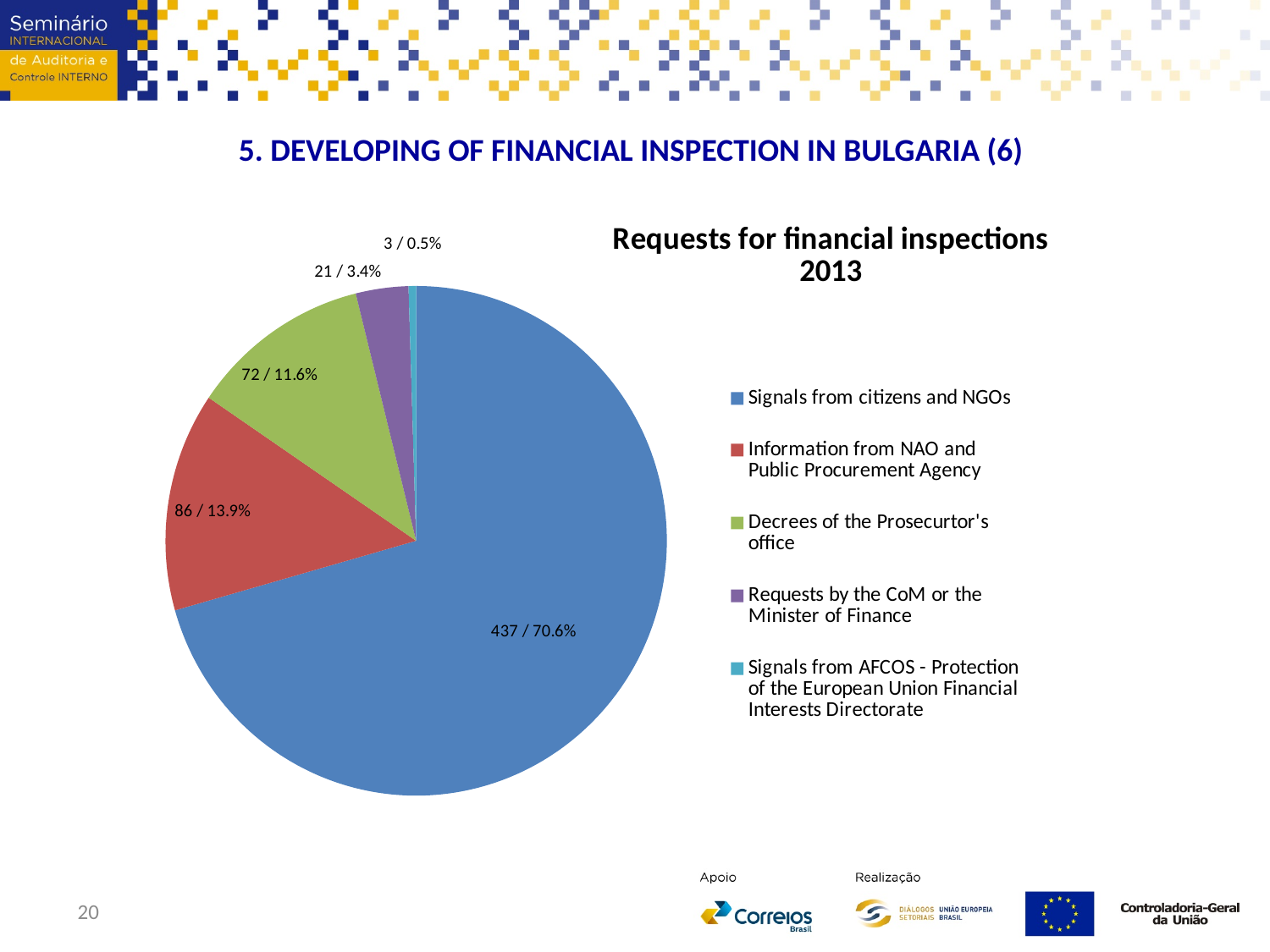
What is the data label for the 'Decrees of the Prosecurtor's office' slice? 72 / 11.6% What is the difference in count between 'Information from NAO and Public Procurement Agency' and 'Decrees of the Prosecurtor's office'? 14 Which category has the largest share of the pie? Signals from citizens and NGOs What percentage share of the pie do 'Signals from AFCOS - Protection of the European Union Financial Interests Directorate' represent? 0.5% Which category has the smallest share of the pie? Signals from AFCOS - Protection of the European Union Financial Interests Directorate What is the data label for the 'Signals from citizens and NGOs' slice? 437 / 70.6% How many categories does the legend of the pie chart list? 5 What is the data label for the 'Information from NAO and Public Procurement Agency' slice? 86 / 13.9% What kind of chart is shown on the slide? Pie chart Which is larger: the count for 'Decrees of the Prosecurtor's office' or for 'Requests by the CoM or the Minister of Finance'? Decrees of the Prosecurtor's office What is the data label for the 'Requests by the CoM or the Minister of Finance' slice? 21 / 3.4% What is the title of the chart? Requests for financial inspections 2013